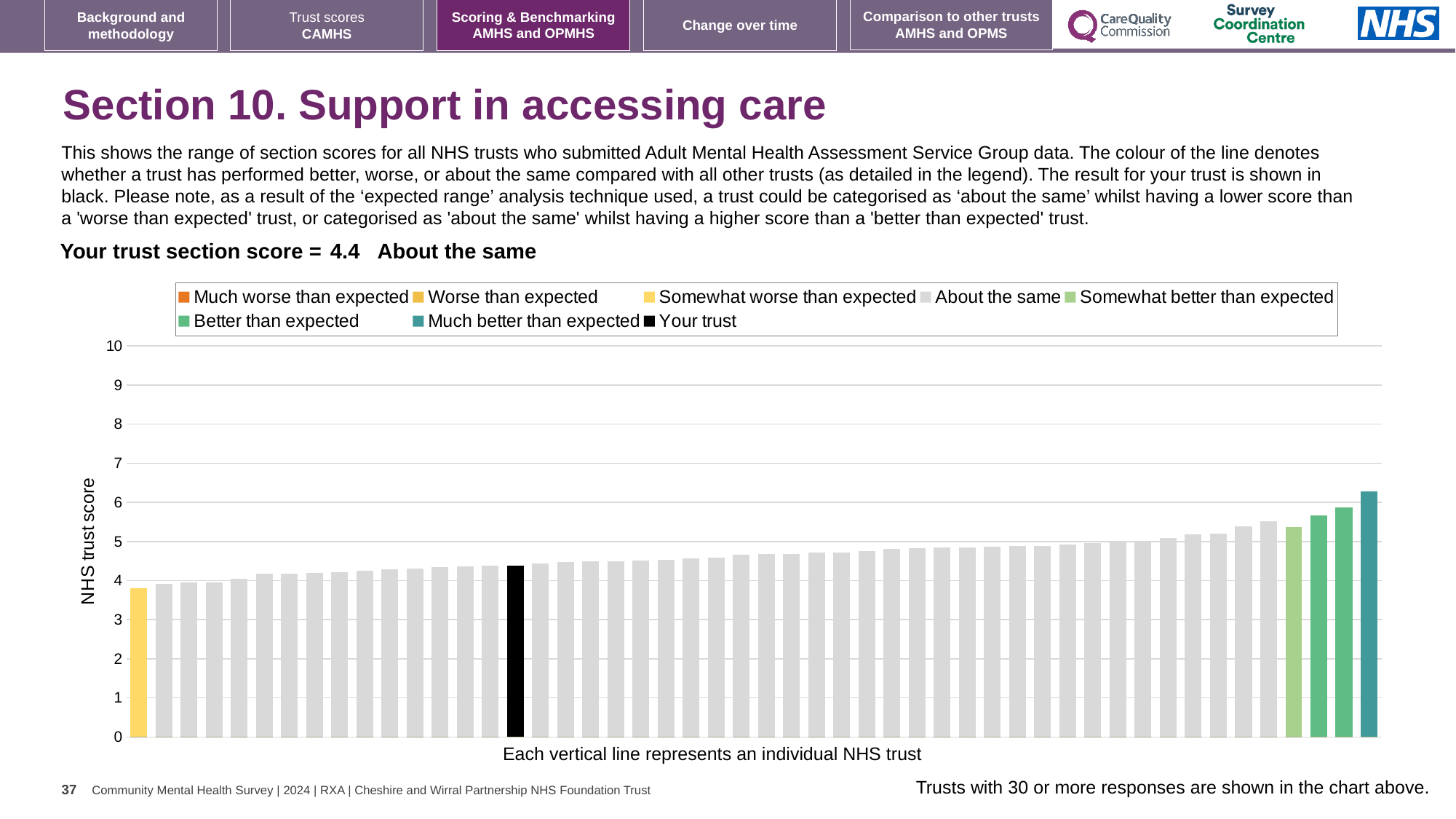
What is the label on the vertical axis of the chart? NHS trust score Do the bar values rise or fall from left to right along the x axis? rise Is the value of the tallest bar in the chart greater or less than 6? greater Is the value for your trust greater or less than 4? greater Is the value of the shortest bar in the chart greater or less than 5? less How many entries does the chart legend list? 8 Which category is your trust's section score placed in? About the same What is your trust's section score for Section 10, Support in accessing care? 4.4 How many bars are coloured as 'Much better than expected'? 1 What colour is the bar representing your trust? black What kind of chart is shown on the slide? bar chart